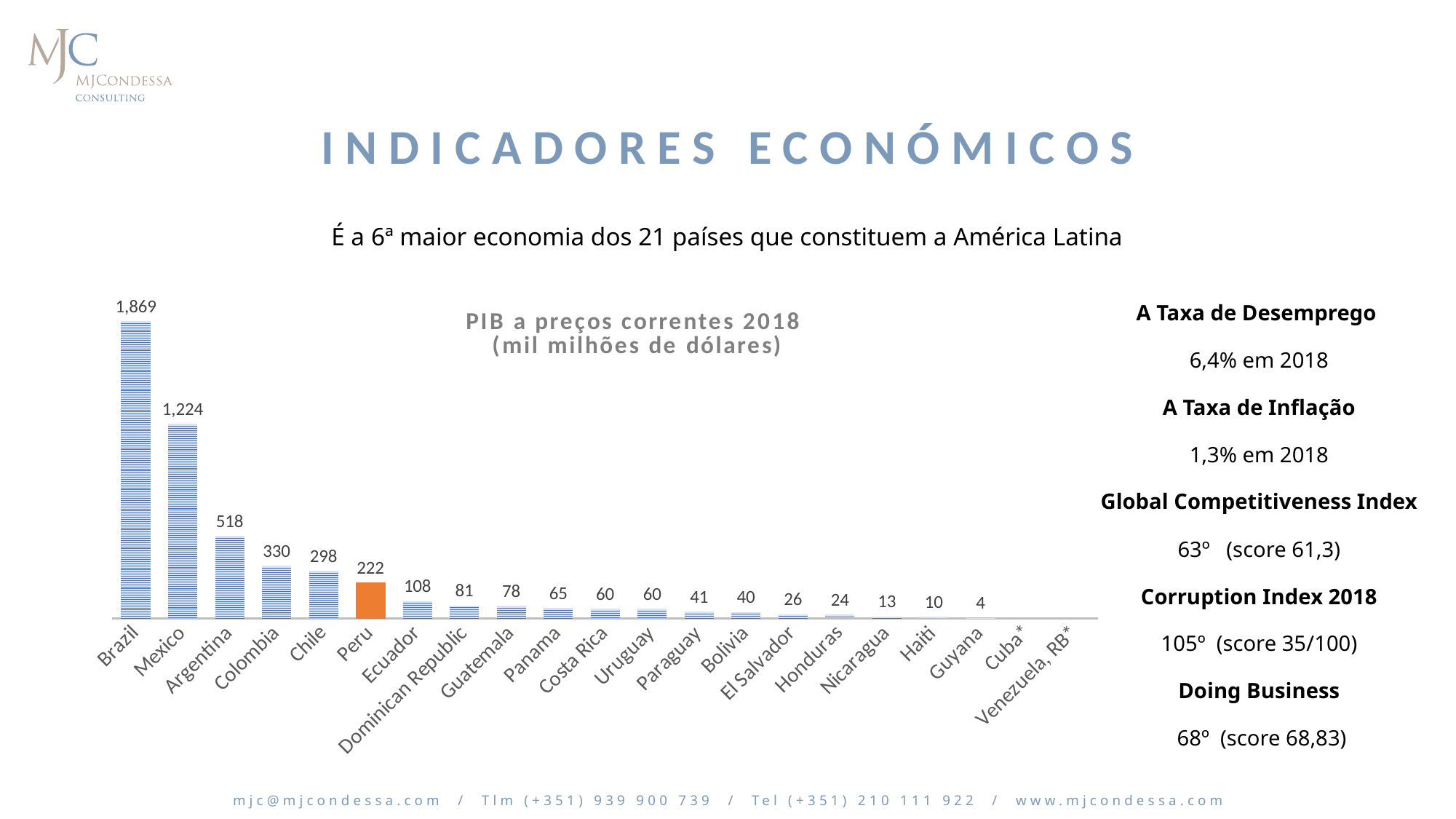
How many countries are shown on the x axis of the chart? 21 What is the value for Dominican Republic? 81 What is the difference between the values for Brazil and Mexico? 645 Which is larger, the value for Argentina or the value for Colombia? Argentina Which is larger, the value for Paraguay or the value for El Salvador? Paraguay What is the title of the chart? PIB a preços correntes 2018 (mil milhões de dólares) What is the value for Mexico? 1,224 What is the difference between the values for Colombia and Chile? 32 Which country's bar is highlighted in orange? Peru Which country has the highest value in the chart? Brazil What is the value for Peru? 222 What type of chart is shown on the slide? bar chart